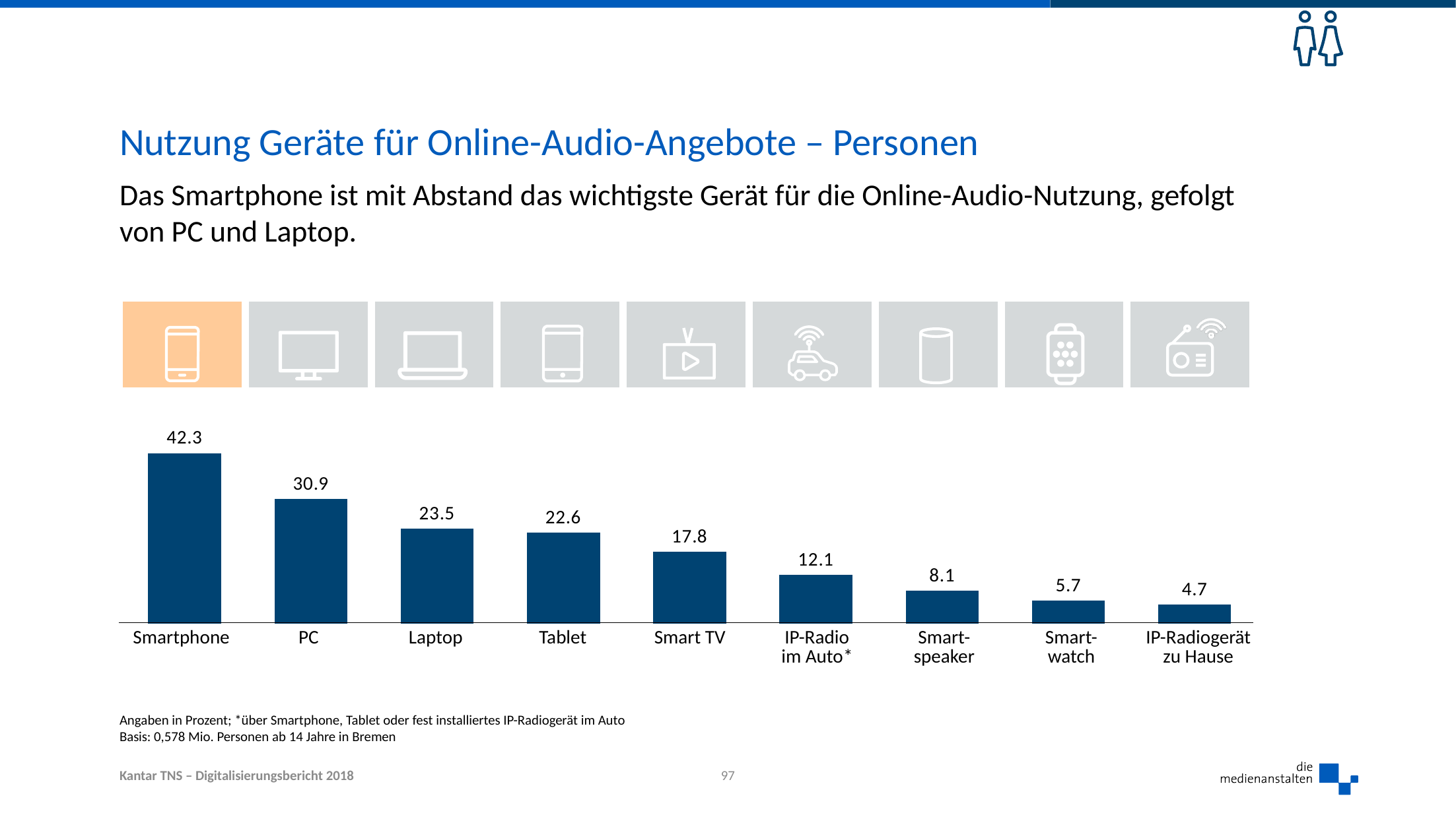
What is the value for Smartwatch? 5.7 What is the value for Laptop? 23.5 Which device has the highest value? Smartphone Which device has the lowest value? IP-Radiogerät zu Hause What is the value for Smartphone? 42.3 What kind of chart is shown on the slide? Bar chart How many devices are shown in the chart? 9 What is the difference between the values for Smartphone and PC? 11.4 What is the difference between the values for Tablet and Smart TV? 4.8 Which has a larger value, Smartspeaker or Smartwatch? Smartspeaker What is the value for IP-Radio im Auto*? 12.1 Do the values rise or fall from left to right along the x axis? Fall